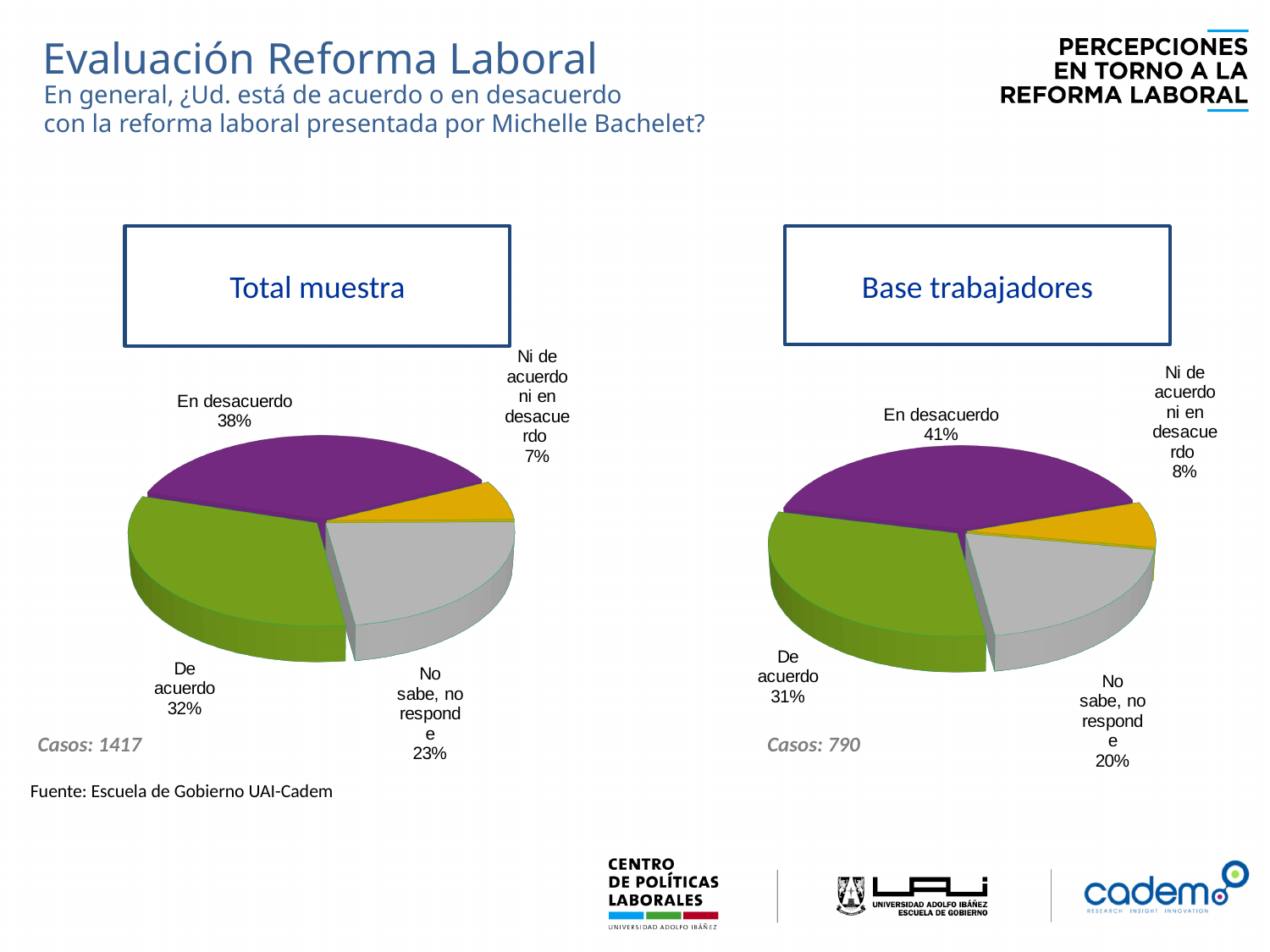
In the 'Base trabajadores' chart, which category has the smallest share? Ni de acuerdo ni en desacuerdo In the 'Base trabajadores' chart, what percentage is 'Ni de acuerdo ni en desacuerdo'? 8% What type of chart is used on this slide? Pie chart In the 'Total muestra' chart, what percentage is 'En desacuerdo'? 38% Which chart shows a higher value for 'En desacuerdo', 'Total muestra' or 'Base trabajadores'? Base trabajadores How many categories does the 'Total muestra' chart show? 4 In the 'Base trabajadores' chart, what is the difference in percentage points between 'En desacuerdo' and 'No sabe, no responde'? 21 In the 'Total muestra' chart, what is the difference in percentage points between 'En desacuerdo' and 'De acuerdo'? 6 In the 'Total muestra' chart, which category has the largest share? En desacuerdo In the 'Total muestra' chart, what percentage is 'No sabe, no responde'? 23% In the 'Base trabajadores' chart, what percentage is 'De acuerdo'? 31% What colour is the 'De acuerdo' slice in the 'Base trabajadores' chart? Green